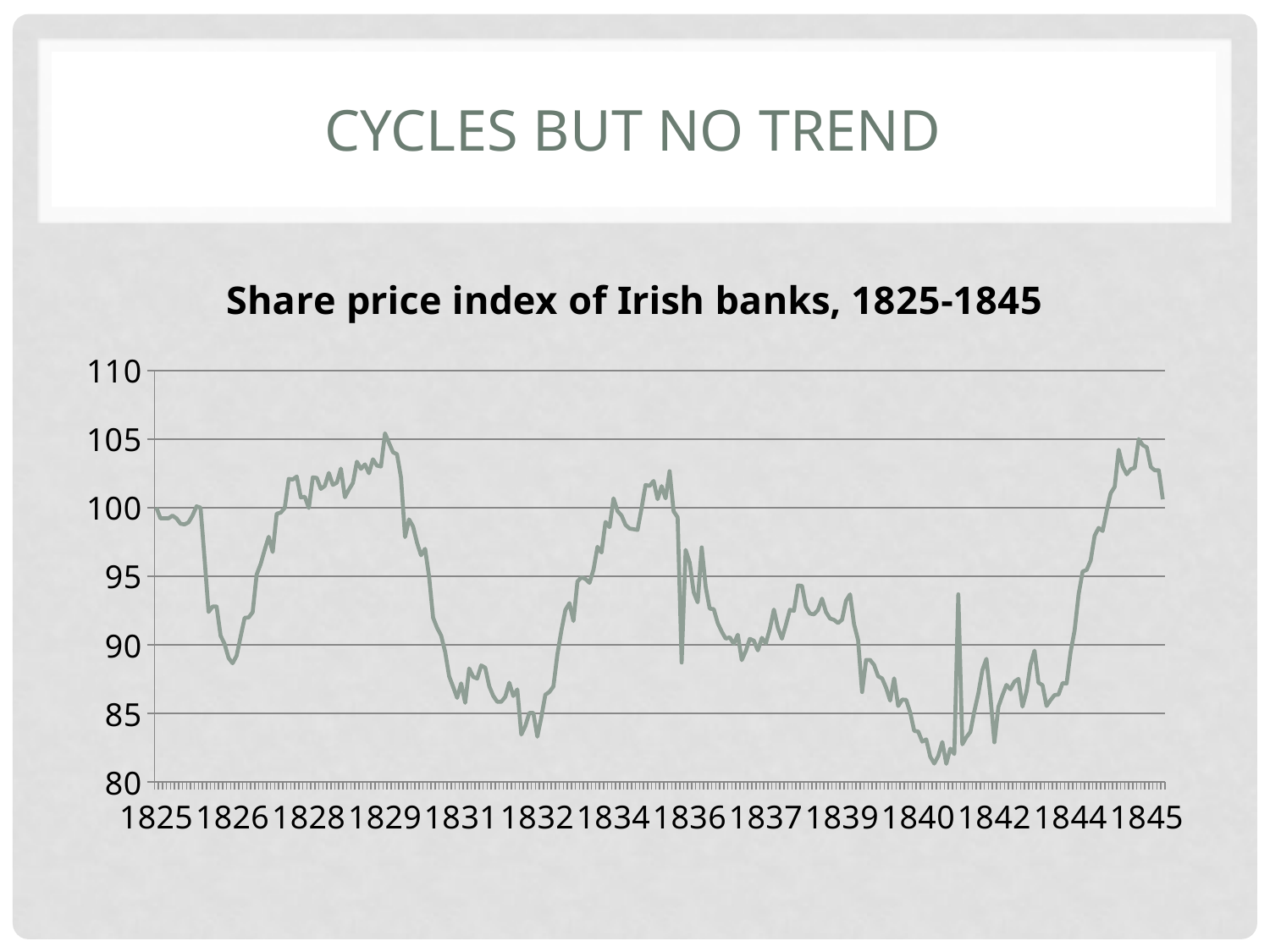
Is the index value at the end of the series in 1845 greater or less than 95? greater Is the peak of the index around 1829 greater or less than 100? greater Is the index value at the 1837 tick greater or less than 95? less What is the highest value shown on the vertical axis of the chart? 110 What kind of chart is shown on the slide? line chart What is the title of the chart? Share price index of Irish banks, 1825-1845 How many lines (series) are plotted on the chart? 1 How many year labels are printed along the x axis of the chart? 14